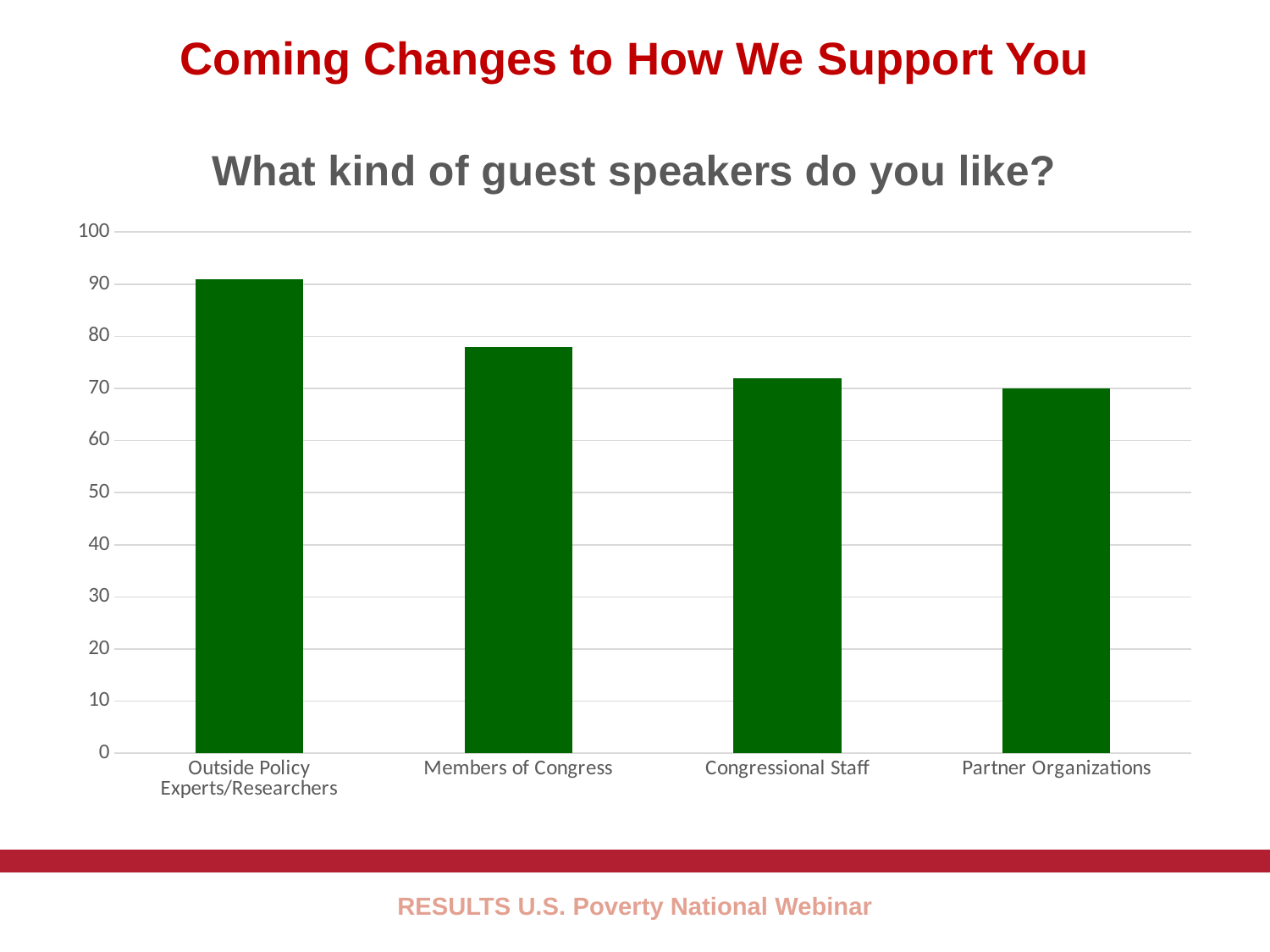
Is the value for Members of Congress greater or less than 70? greater What is the title of the chart? What kind of guest speakers do you like? Which is larger, the value for Outside Policy Experts/Researchers or the value for Members of Congress? Outside Policy Experts/Researchers How many categories are shown on the x axis of the chart? 4 What kind of chart is shown on the slide? bar chart Which category has the highest bar in the chart? Outside Policy Experts/Researchers Is the value for Partner Organizations greater or less than 60? greater Do the bar values rise or fall from left to right across the x axis? fall Is the value for Members of Congress greater or less than 80? less Which is larger, the value for Members of Congress or the value for Partner Organizations? Members of Congress